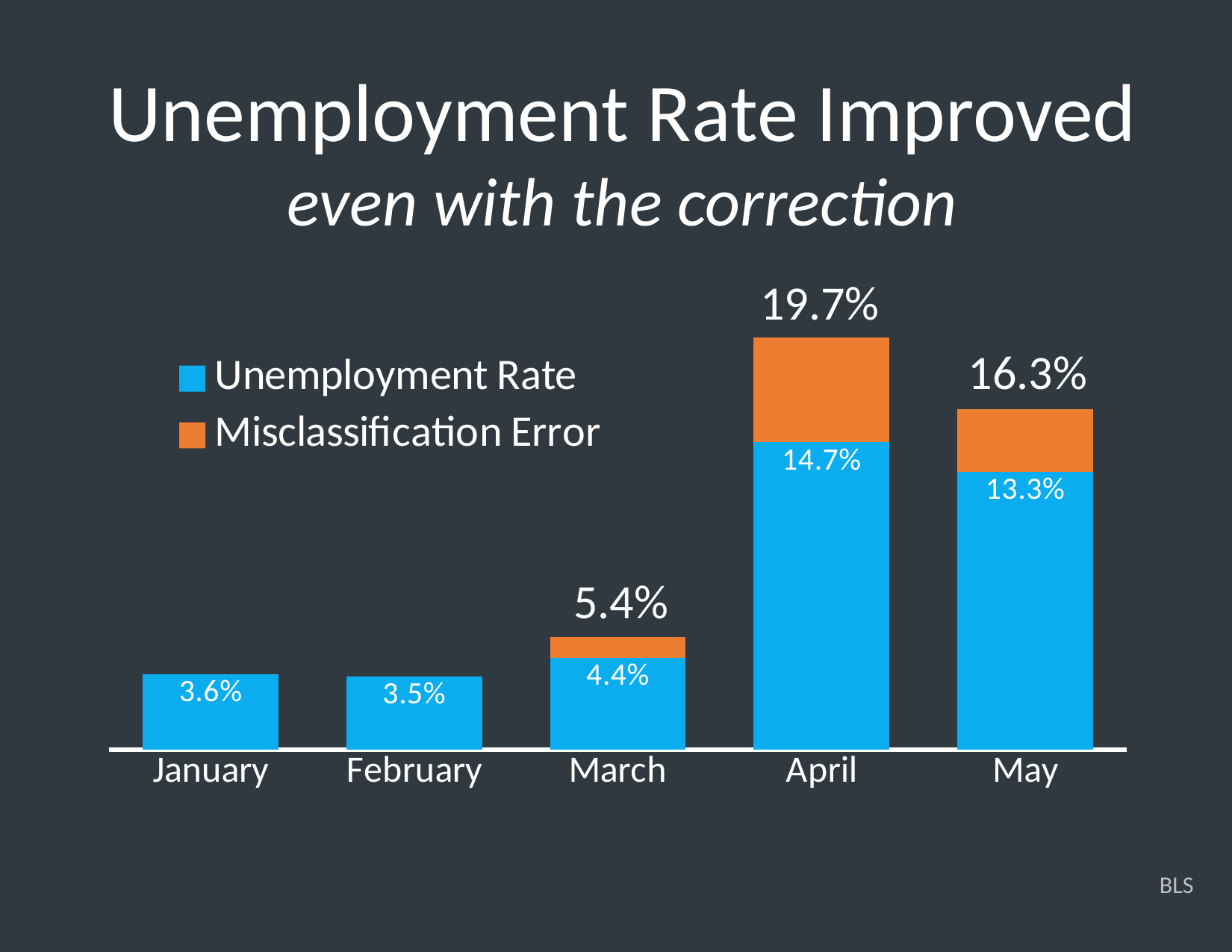
What is the total height of the stacked bar for March? 5.4% What is the difference between the total for April and the total for May? 3.4% What is the difference between the Unemployment Rate in April and in May? 1.4% How many months are shown on the x axis? 5 Which month has the highest Unemployment Rate? April Which is larger, the Unemployment Rate for March or for February? March What is the Unemployment Rate for January? 3.6% What is the Unemployment Rate for April? 14.7% What kind of chart is shown on the slide? Stacked bar chart How many series does the legend list? 2 What is the total height of the stacked bar for May? 16.3% Which month has the lowest Unemployment Rate? February